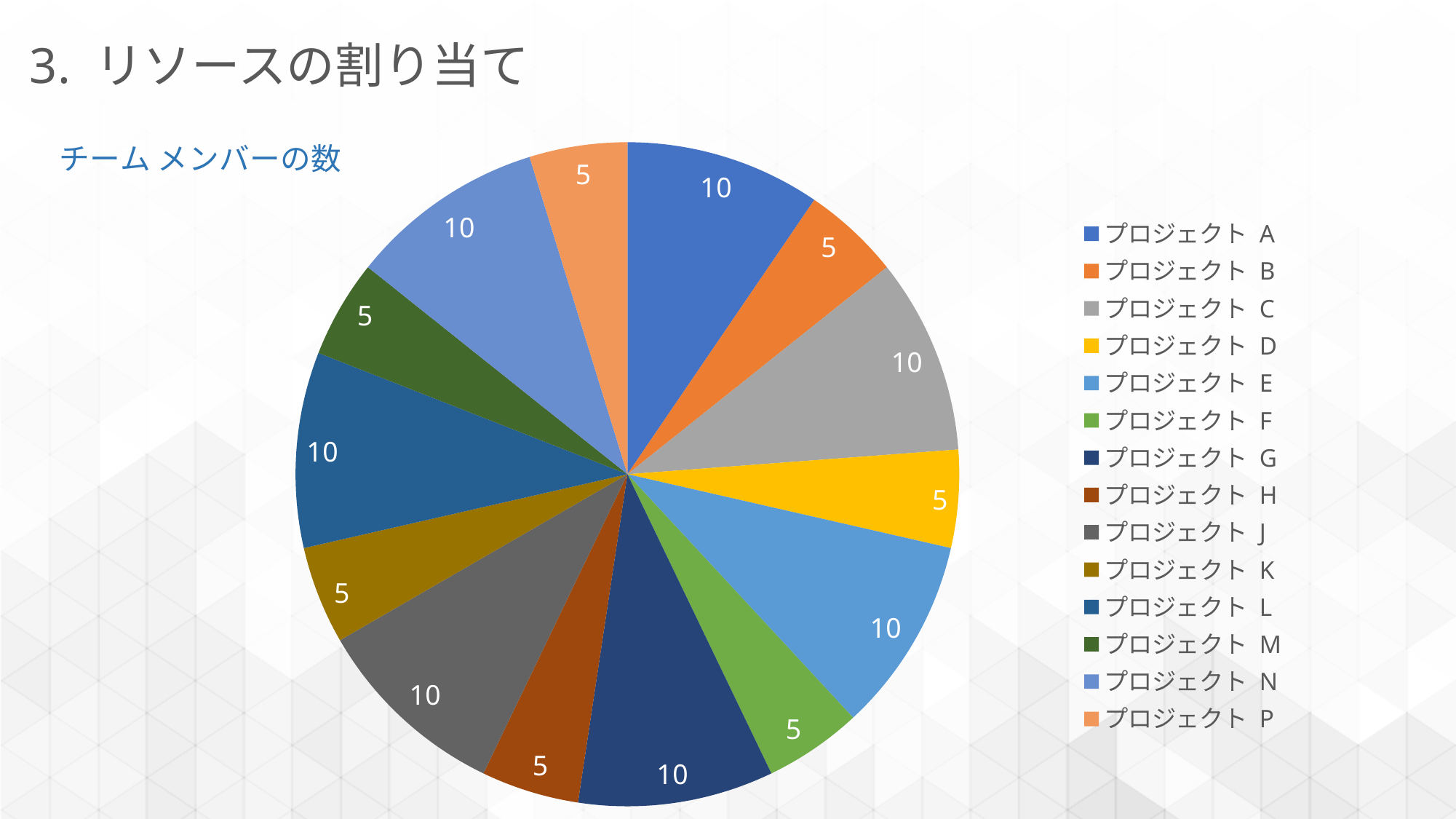
What is the value for プロジェクト A? 10 Which is larger, the value for プロジェクト C or the value for プロジェクト D? プロジェクト C What is the difference between the value for プロジェクト E and the value for プロジェクト F? 5 What is the value for プロジェクト G? 10 How many slices does the pie chart have? 14 What is the value for プロジェクト B? 5 What is the value for プロジェクト K? 5 What is the smallest value shown on any slice of the pie chart? 5 What is the value for プロジェクト N? 10 What is the largest value shown on any slice of the pie chart? 10 What kind of chart is shown on the slide? pie chart What is the title of the chart? チーム メンバーの数